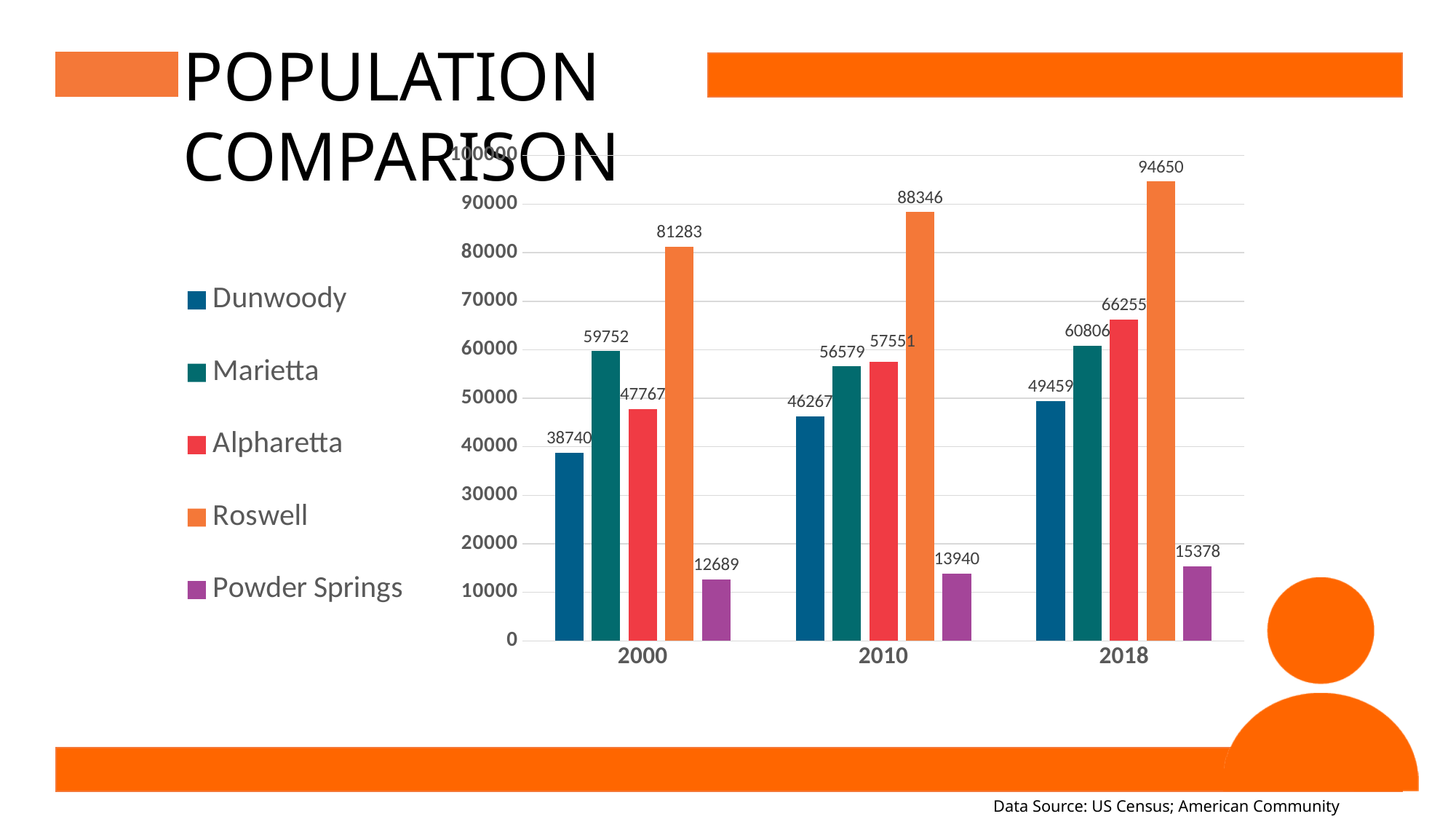
Does the population of Alpharetta rise or fall from 2000 to 2018? Rise What was the population of Powder Springs in 2010? 13940 How many years are shown on the x axis? 3 Which city had the lowest population in 2018? Powder Springs How many cities does the legend list? 5 Which was larger in 2000, the population of Marietta or Alpharetta? Marietta What was the population of Roswell in 2018? 94650 Which was larger in 2018, the population of Alpharetta or Marietta? Alpharetta What was the population of Dunwoody in 2000? 38740 What kind of chart is shown on the slide? Bar chart Which city had the highest population in 2010? Roswell What is the difference between Roswell's population in 2018 and in 2000? 13367